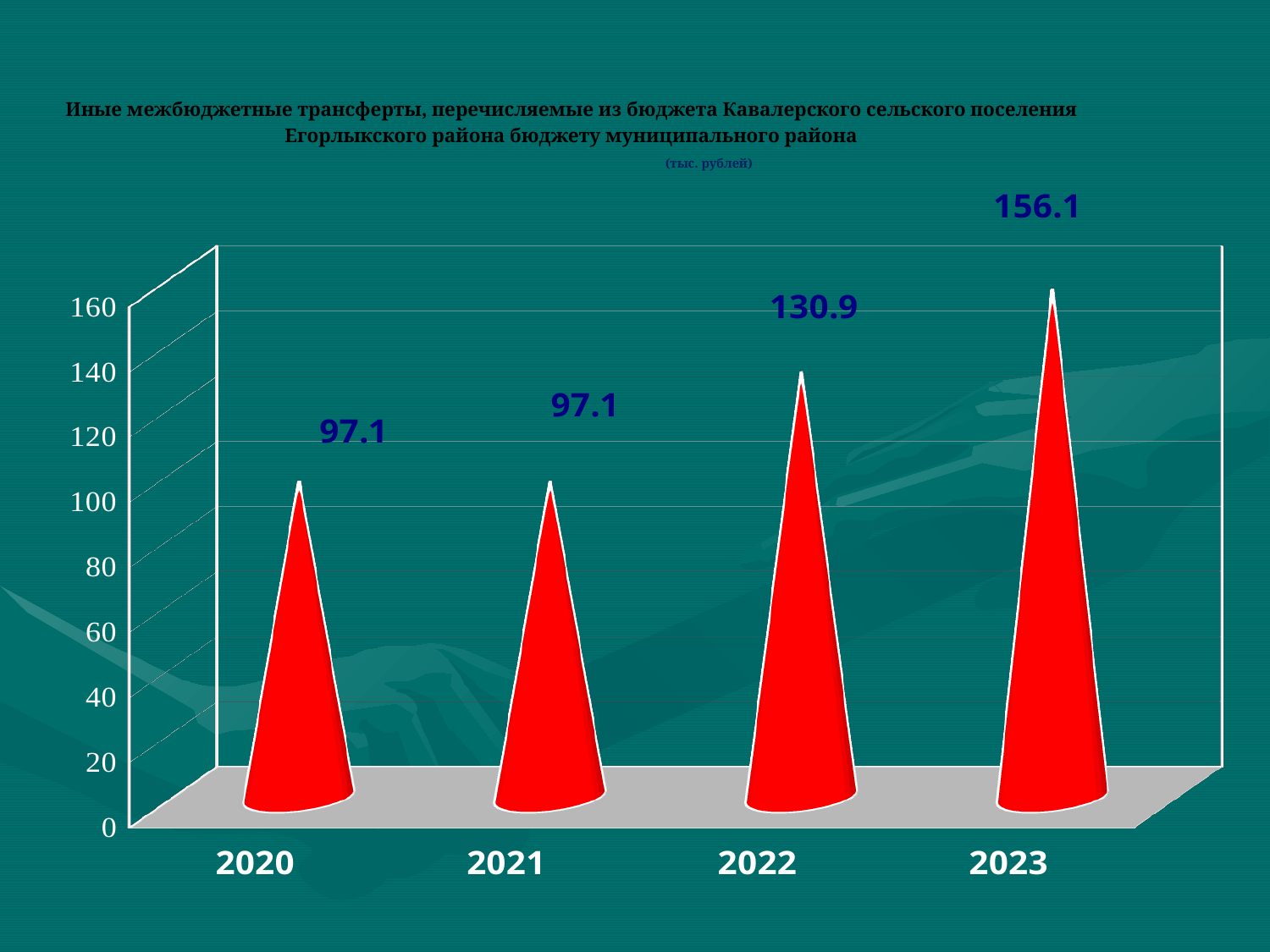
How many years are shown on the x axis? 4 In what units are the values given, according to the subtitle? тыс. рублей What kind of chart is shown on the slide? bar chart Is the value for 2023 greater or less than 140? greater Which year has the highest value? 2023 Do the values rise or fall from 2021 to 2023? rise What is the value for 2023? 156.1 What is the difference between the values for 2023 and 2022? 25.2 What is the difference between the values for 2022 and 2021? 33.8 What is the value for 2022? 130.9 Which is larger, the value for 2021 or the value for 2022? 2022 What is the value for 2020? 97.1